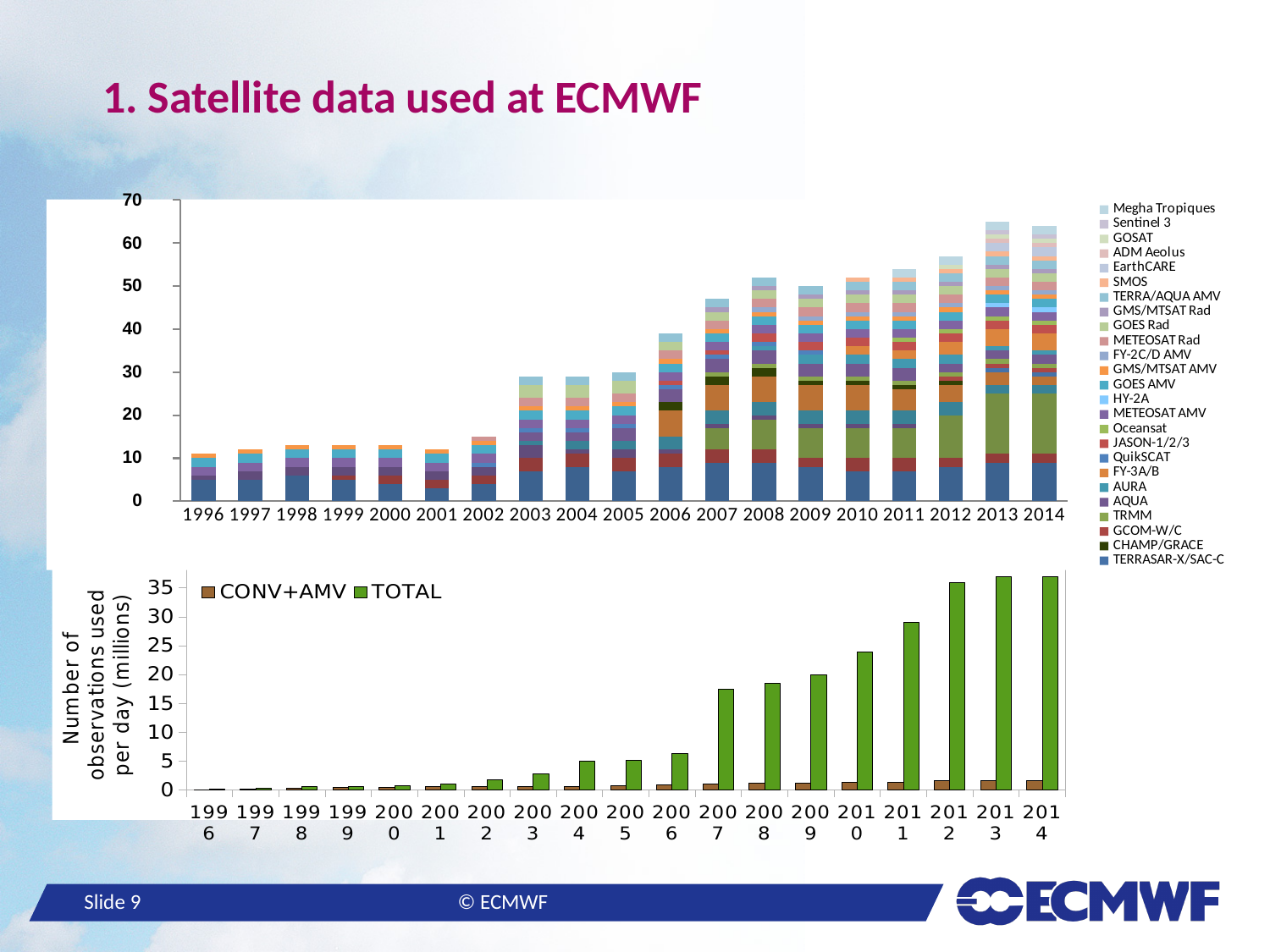
What kind of chart is the bottom chart on the slide? bar chart In the bottom chart, does the TOTAL series generally rise or fall from 1996 to 2014? rise In the bottom chart, what are the two series named in the legend? CONV+AMV and TOTAL What kind of chart is the top chart on the slide? stacked bar chart In the top chart, is the total stacked value for 2002 greater or less than 20? less In the bottom chart, how many series does the legend list? 2 In the top chart, which year has the larger total stacked value, 2005 or 2006? 2006 In the top chart, is the total stacked value for 2013 greater or less than 60? greater In the top chart, is the total stacked value for 2012 greater or less than 50? greater In the bottom chart, which series has the larger value in 2014, CONV+AMV or TOTAL? TOTAL In the top chart, how many years are shown on the x axis? 19